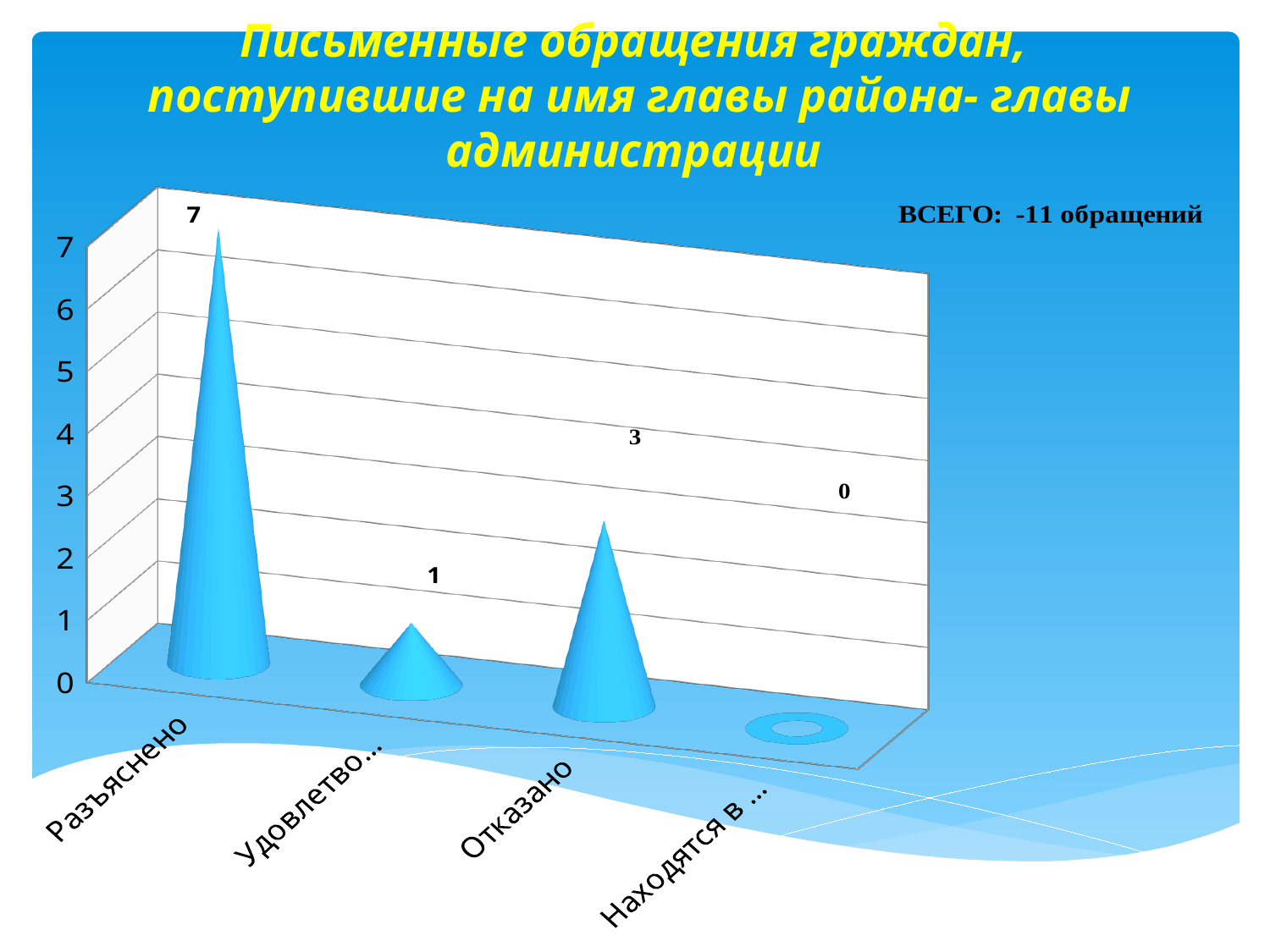
What is the value for Отказано? 3 What is the value for Разъяснено? 7 Which is larger, the value for Отказано or the value for Удовлетво...? Отказано What total number of appeals (ВСЕГО) is stated on the slide? 11 обращений What is the value for the last category (Находятся в ...)? 0 Which category has the lowest value? Находятся в ... What is the value for the second category (Удовлетво...)? 1 What is the difference between the values for Разъяснено and Отказано? 4 Is the value for Разъяснено greater or less than 5? greater Which category has the highest value? Разъяснено How many categories are shown on the x axis? 4 What kind of chart is shown on the slide? bar chart